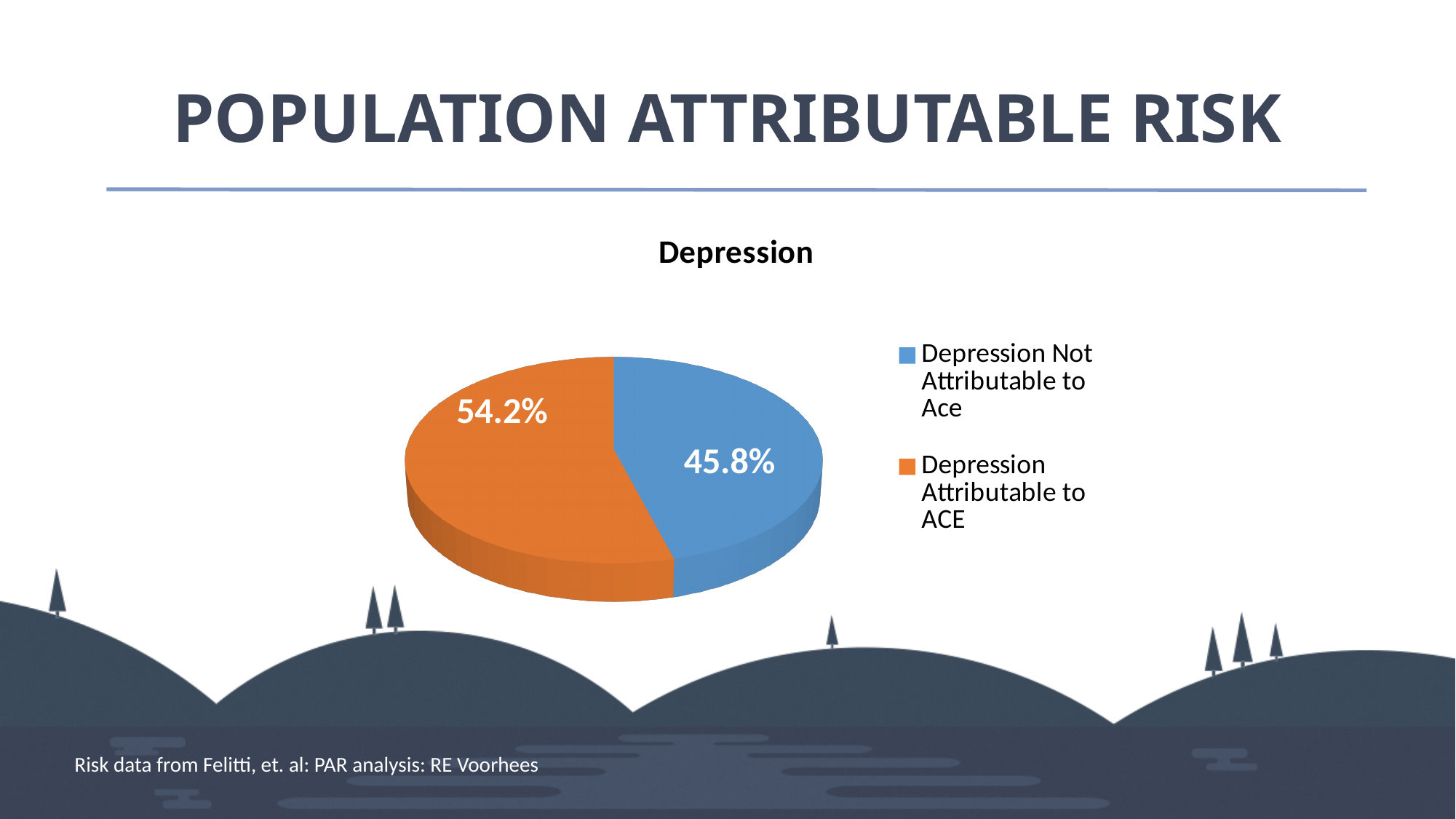
Which slice is the largest? Depression Attributable to ACE What kind of chart is shown on the slide? Pie chart How many slices does the pie chart have? 2 What is the title of the chart? Depression Which is larger: Depression Attributable to ACE or Depression Not Attributable to Ace? Depression Attributable to ACE What is the difference in percentage points between the Depression Attributable to ACE slice and the Depression Not Attributable to Ace slice? 8.4 How many entries does the legend list? 2 Is the share for Depression Not Attributable to Ace greater or less than 50%? less What share of the pie is Depression Not Attributable to Ace? 45.8% What colour is the Depression Attributable to ACE slice? Orange What share of the pie is Depression Attributable to ACE? 54.2% Which slice is the smallest? Depression Not Attributable to Ace